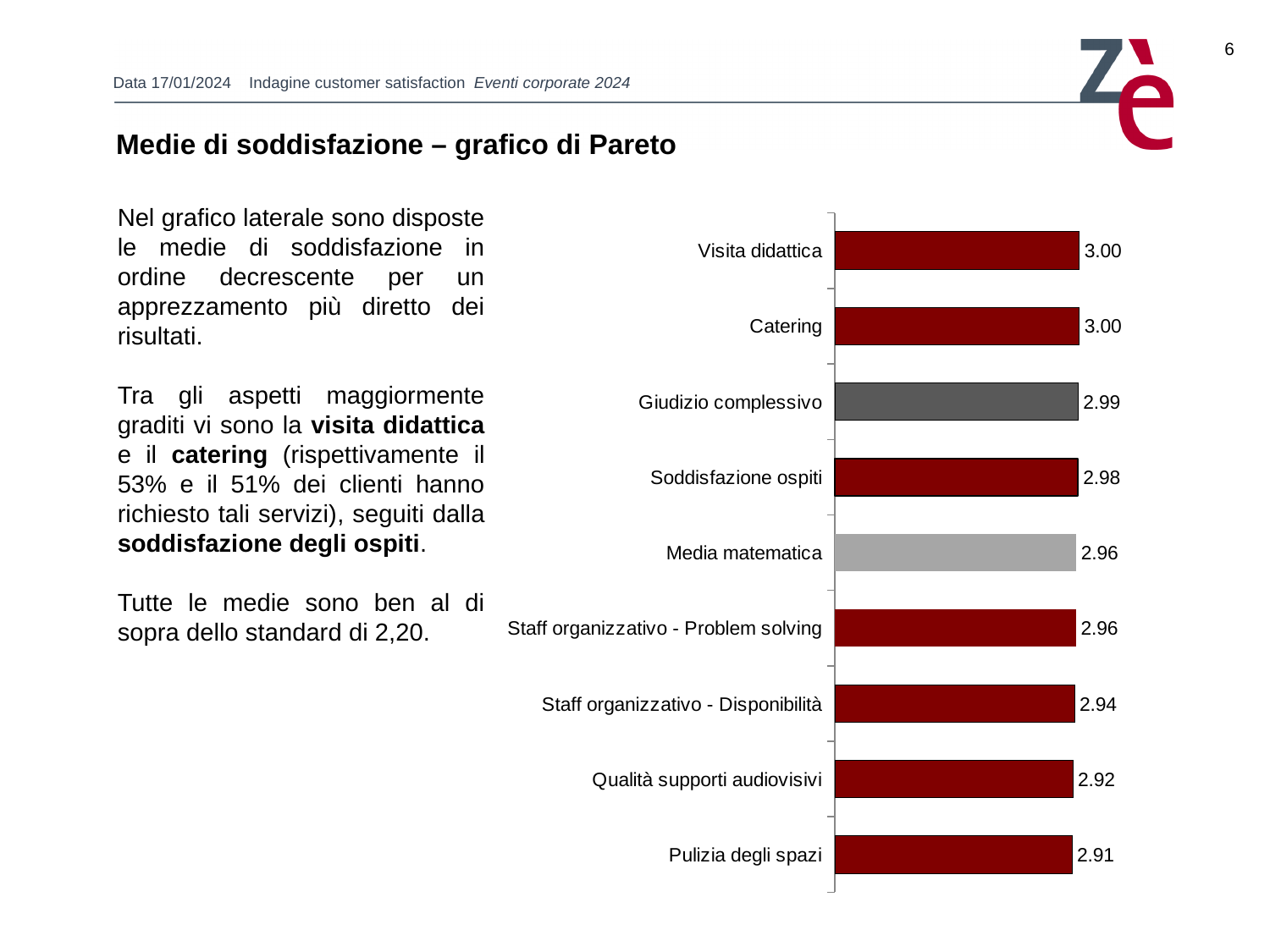
What is the value for Qualità supporti audiovisivi? 2.92 What colour is the bar for Giudizio complessivo? Dark grey Which category has the lowest value? Pulizia degli spazi What is the value for Giudizio complessivo? 2.99 What is the value for Soddisfazione ospiti? 2.98 How many categories are shown in the chart? 9 What is the value for Staff organizzativo - Disponibilità? 2.94 What is the difference between the values for Visita didattica and Pulizia degli spazi? 0.09 What is the difference between the values for Catering and Staff organizzativo - Disponibilità? 0.06 Which is larger, the value for Catering or the value for Qualità supporti audiovisivi? Catering What is the value for Visita didattica? 3.00 What kind of chart is shown on the slide? Bar chart